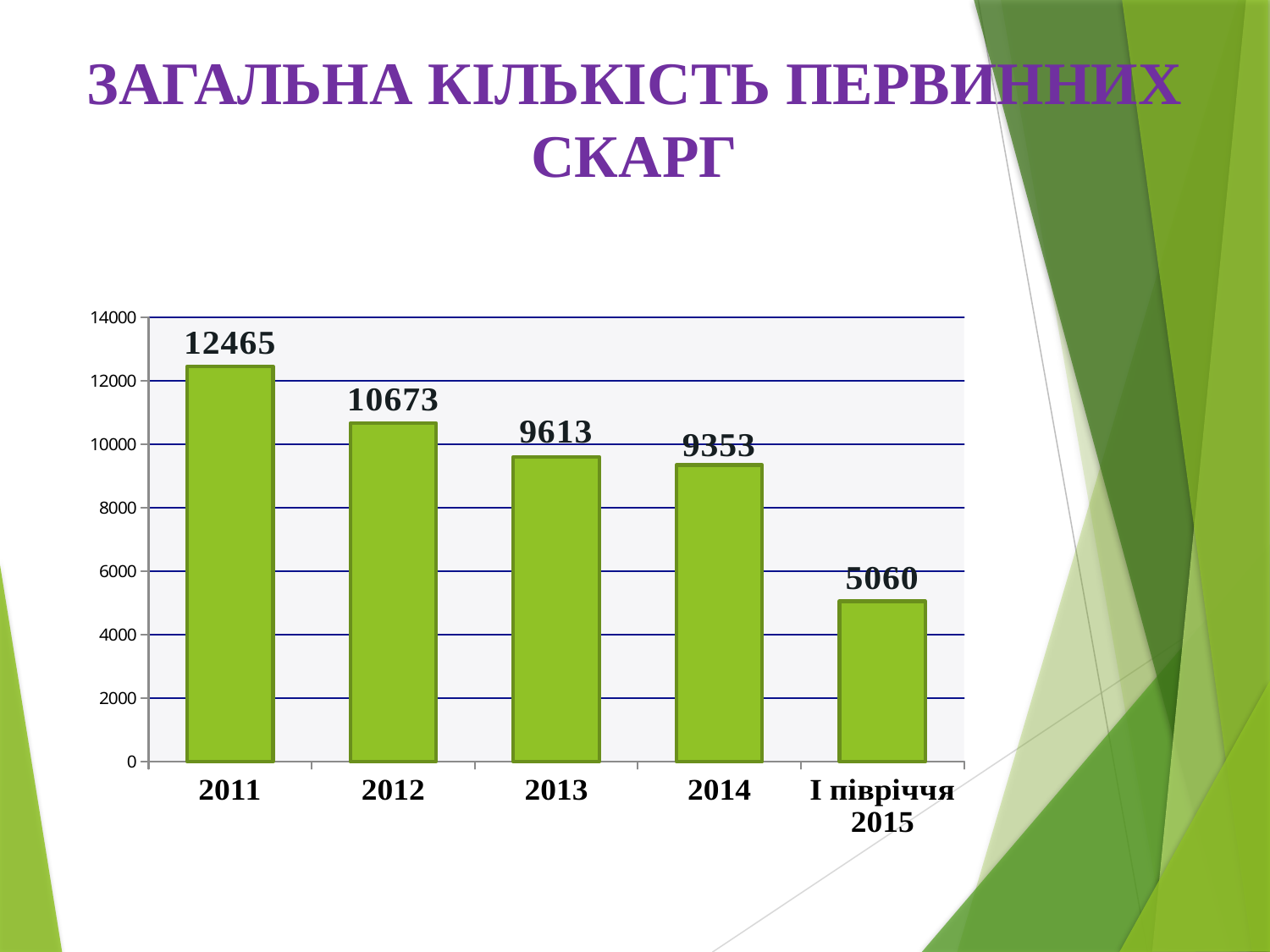
What is the value for 2013? 9613 What kind of chart is shown on the slide? bar chart What is the difference between the values for 2013 and 2014? 260 Do the values rise or fall from 2011 to І півріччя 2015? fall Which category has the lowest value? І півріччя 2015 Which category has the highest value? 2011 What is the value for І півріччя 2015? 5060 How many categories are shown on the x axis? 5 What is the value for 2011? 12465 What is the difference between the values for 2011 and 2012? 1792 Is the value for 2014 greater or less than 10000? less Which is larger, the value for 2012 or the value for 2014? 2012